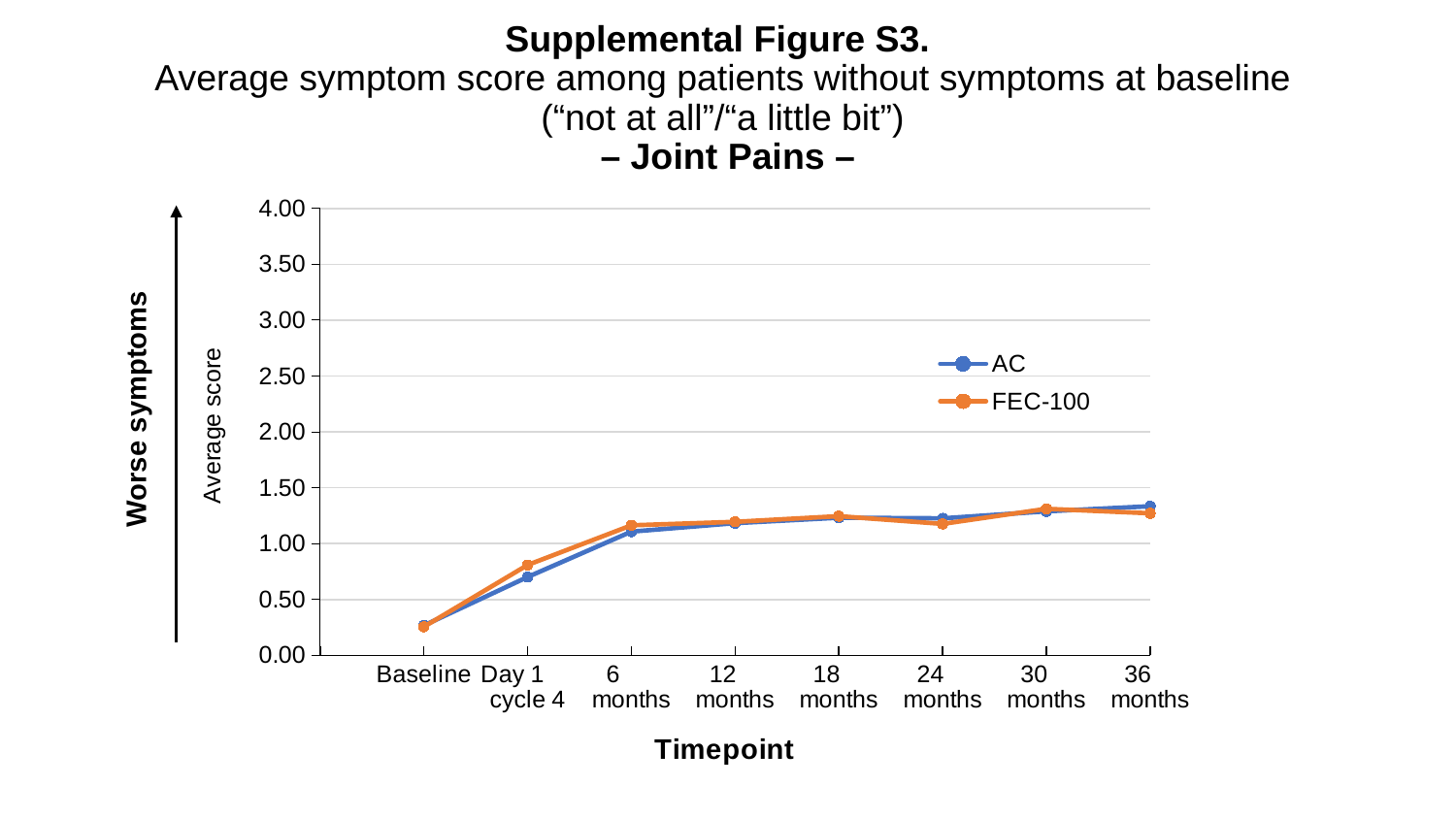
Which two series are listed in the legend? AC and FEC-100 What kind of chart is shown on the slide? line chart At which timepoint is the FEC-100 series lowest? Baseline Is the AC value at Baseline greater or less than 0.50? less How many timepoints are plotted along the x axis? 8 How many series does the legend list? 2 Is the FEC-100 value at 36 months greater or less than 1.50? less Is the FEC-100 value at Day 1 cycle 4 greater or less than 0.50? greater At which timepoint is the AC series lowest? Baseline At Day 1 cycle 4, which series has the higher average score, AC or FEC-100? FEC-100 Do the average scores rise or fall from Baseline to 6 months? rise